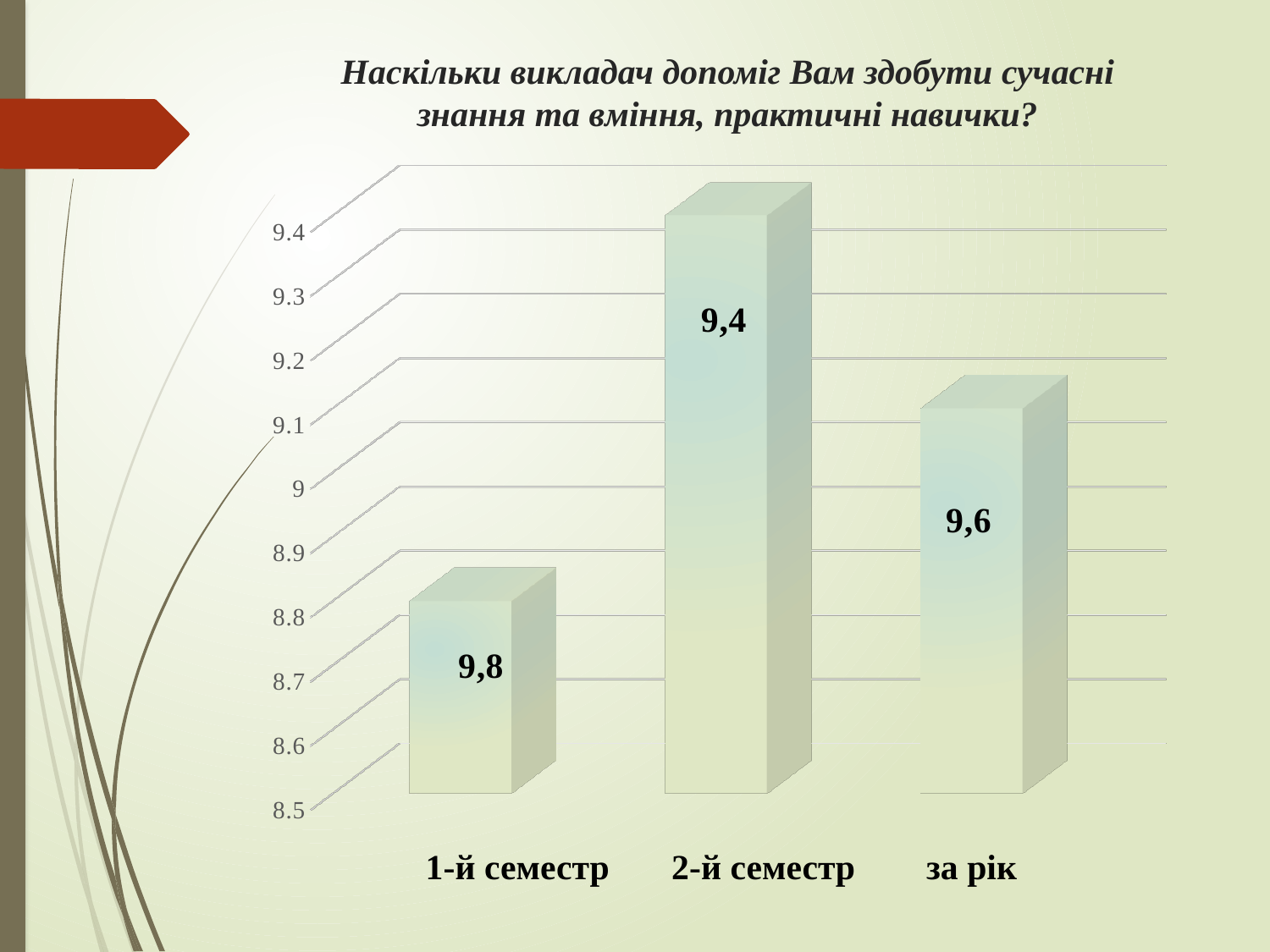
How many categories are shown on the x axis of the chart? 3 What value is labelled on the bar for за рік? 9,6 What kind of chart is shown on the slide? bar chart What value is labelled on the bar for 2-й семестр? 9,4 What value is labelled on the bar for 1-й семестр? 9,8 What is the lowest tick value shown on the vertical axis? 8.5 What is the title of the chart? Наскільки викладач допоміг Вам здобути сучасні знання та вміння, практичні навички? What is the label of the third category on the x axis? за рік